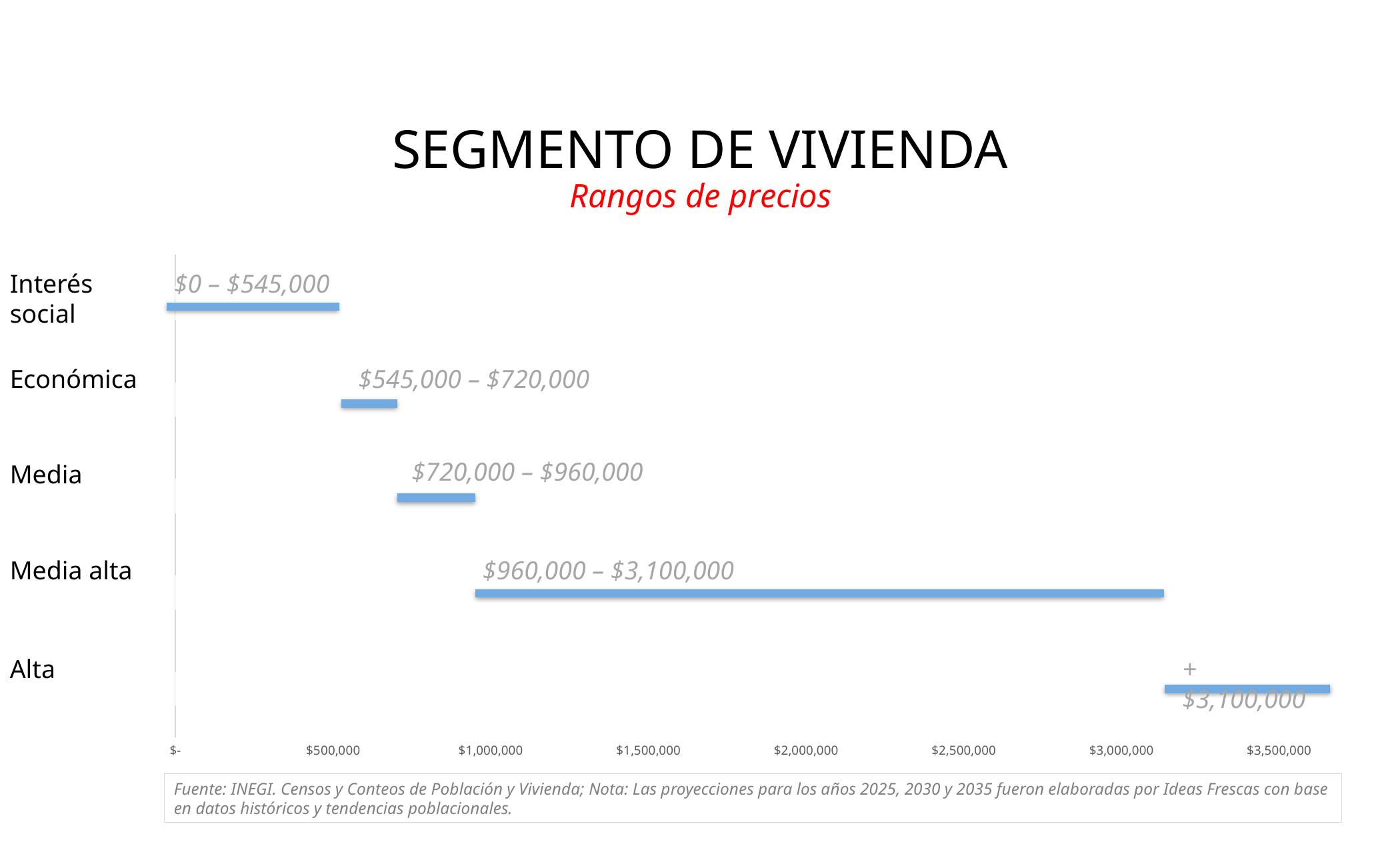
Is the upper limit of the Media segment greater or less than $1,000,000? less What price range is shown for the Media alta segment? $960,000 – $3,100,000 How wide is the price range for the Media segment (upper limit minus lower limit)? $240,000 What price range is shown for the Interés social segment? $0 – $545,000 What is the lower price limit shown for the Alta segment? $3,100,000 What is the main title of the chart? SEGMENTO DE VIVIENDA What kind of chart is used to show the price ranges? Bar chart What price range is shown for the Media segment? $720,000 – $960,000 Which segment has the widest price range among those with both limits printed? Media alta How wide is the price range for the Económica segment (upper limit minus lower limit)? $175,000 How many housing segments are plotted on the chart? 5 What price range is shown for the Económica segment? $545,000 – $720,000